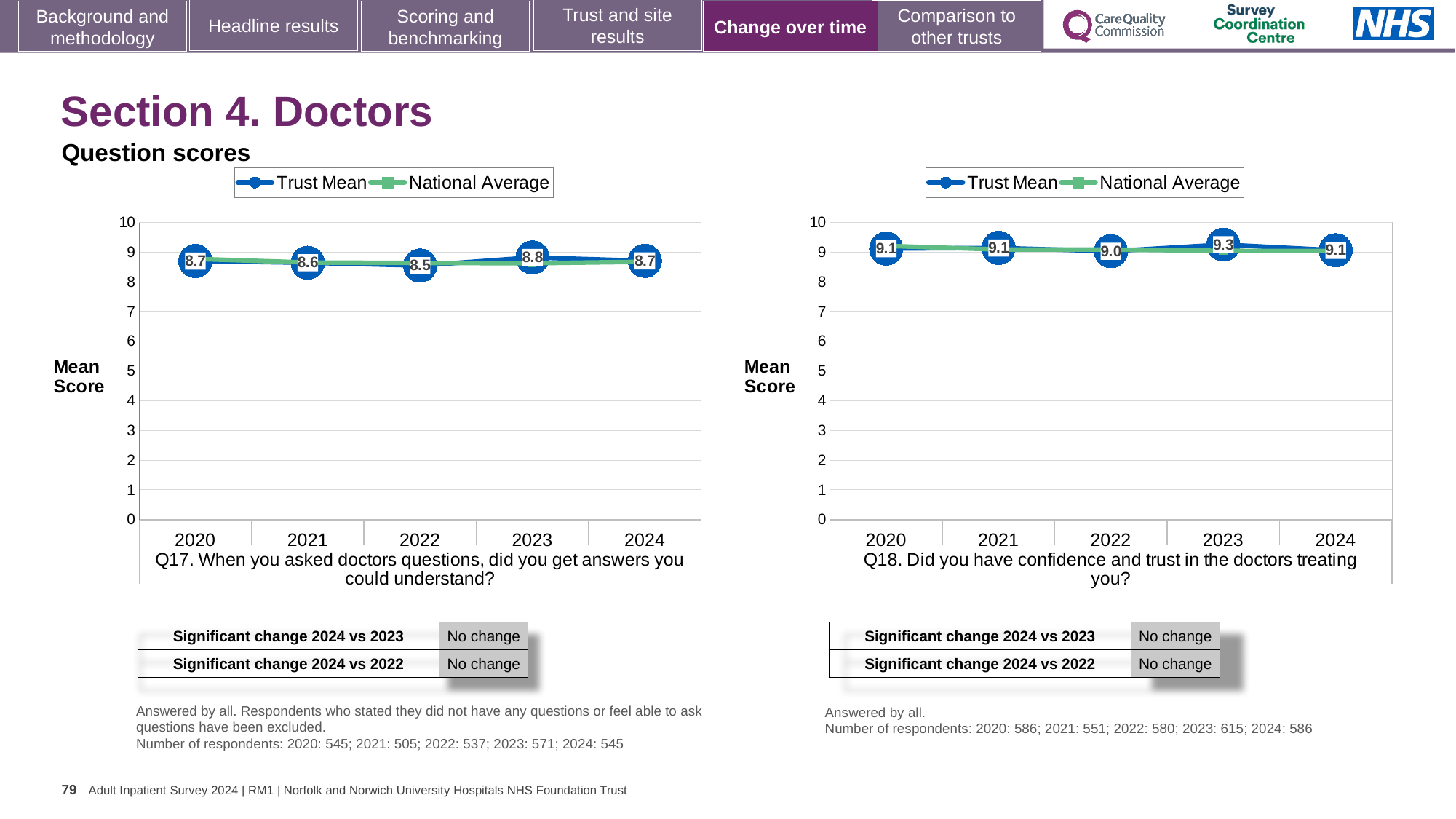
In the Q18 chart, which is larger, the Trust Mean score for 2023 or for 2022? 2023 In the Q17 chart, what is the Trust Mean score for 2022? 8.5 In the Q17 chart, which year has the lowest Trust Mean score? 2022 In the Q17 chart, what is the difference between the Trust Mean scores for 2023 and 2022? 0.3 In the Q18 chart, is the Trust Mean score for 2024 greater or less than 8? greater How many series does the legend of the Q17 chart list? 2 In the Q18 chart, which year has the highest Trust Mean score? 2023 In the Q18 chart, what is the Trust Mean score for 2023? 9.3 In the Q18 chart, what is the Trust Mean score for 2022? 9.0 In the Q17 chart, what is the Trust Mean score for 2023? 8.8 In the Q17 chart, how many years are plotted on the x axis? 5 What type of chart is the Q18 chart? Line chart